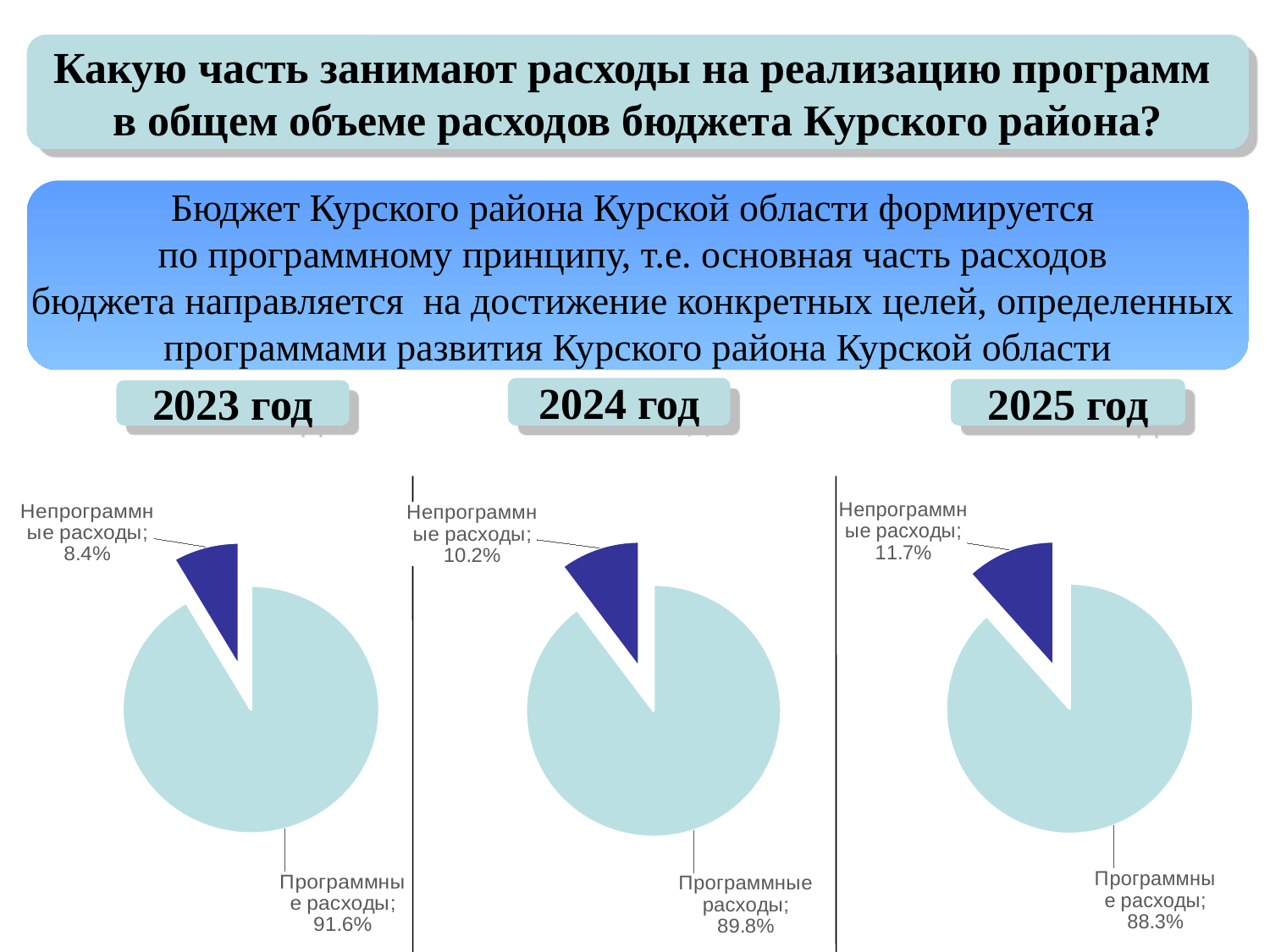
How many slices does the 2024 год pie chart have? 2 What is the difference between the Программные расходы share in 2023 год and in 2025 год? 3.3% In the 2024 год pie chart, what share is Непрограммные расходы? 10.2% In the 2024 год pie chart, what share is Программные расходы? 89.8% Is the Непрограммные расходы share larger in the 2024 год chart or the 2025 год chart? 2025 год In the 2025 год pie chart, which slice is the largest? Программные расходы What type of chart is used for each year on the slide? Pie chart In the 2023 год pie chart, which slice is the smallest? Непрограммные расходы In the 2025 год pie chart, what share is Программные расходы? 88.3% In the 2023 год pie chart, what share is Программные расходы? 91.6% In the 2023 год pie chart, what share is Непрограммные расходы? 8.4% In the 2025 год pie chart, what share is Непрограммные расходы? 11.7%